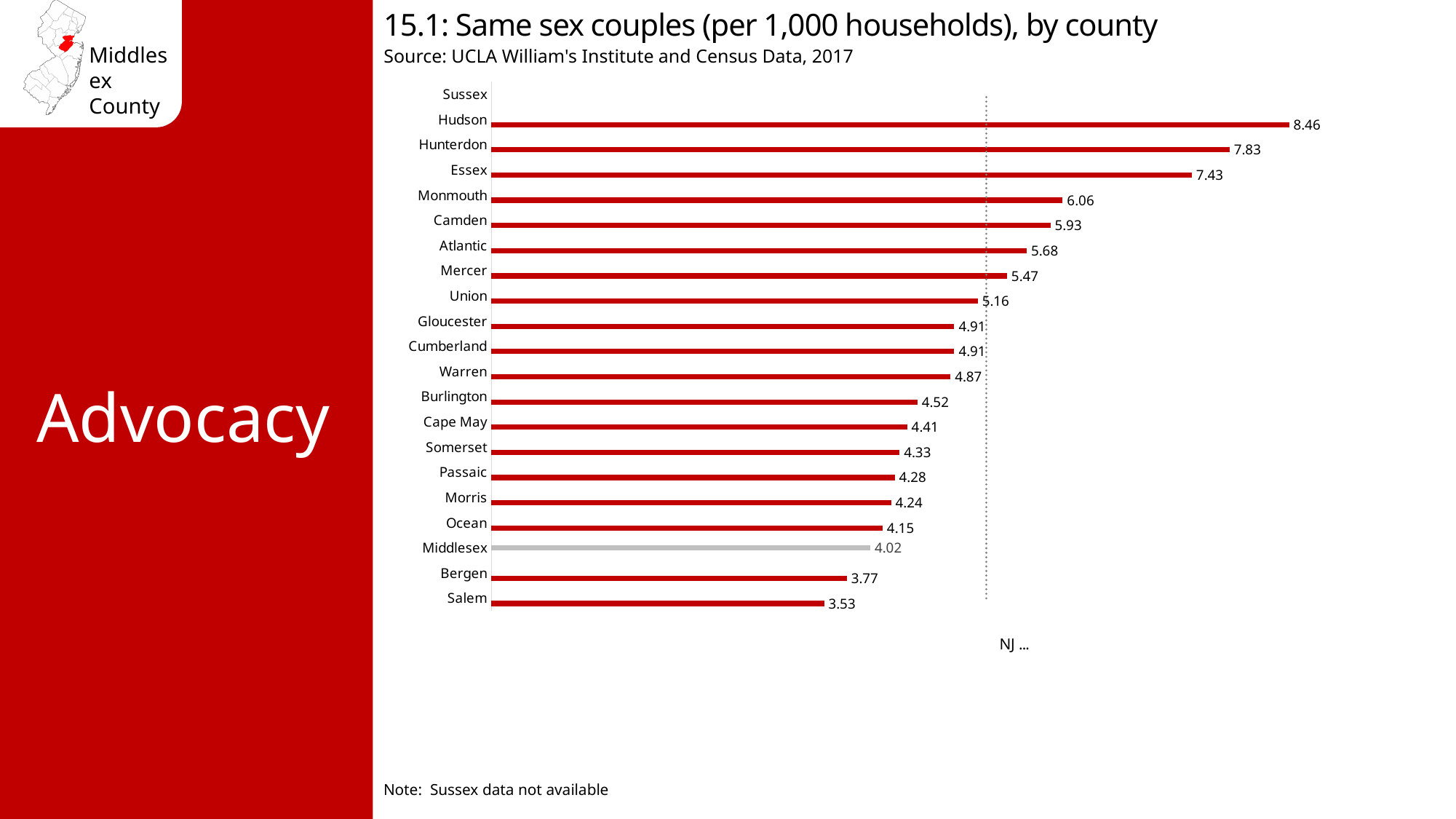
What is the difference between the values for Hudson and Middlesex? 4.44 Which county's bar is shown in grey rather than red? Middlesex How many counties are listed on the chart's axis? 21 Which has a larger value, Monmouth or Camden? Monmouth What is the value for Middlesex County? 4.02 What type of chart is shown on the slide? Bar chart Which county with data shown has the lowest value? Salem What is the value for Salem County? 3.53 What is the value for Hudson County? 8.46 Which county has the highest value of same sex couples per 1,000 households? Hudson What is the difference between the values for Essex and Hunterdon? 0.40 Which county has no data shown on the chart? Sussex